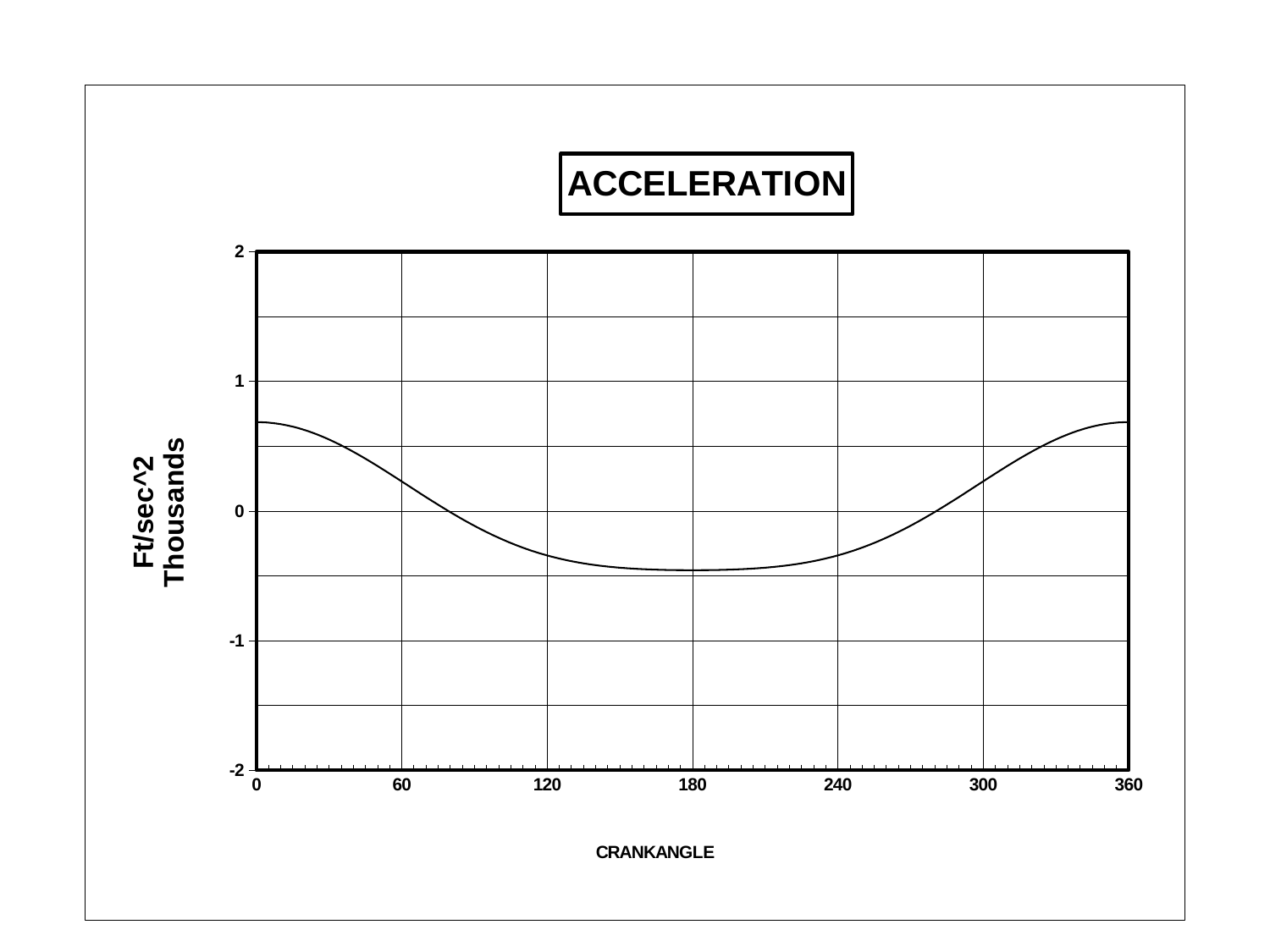
Is the acceleration value at a crank angle of 180 greater or less than -1? greater What is the title of the chart? ACCELERATION What is the label of the x axis? CRANKANGLE What kind of chart is shown on the slide? line chart Which is larger, the acceleration at a crank angle of 0 or at a crank angle of 180? 0 Is the acceleration value at a crank angle of 0 greater or less than 0? greater Is the acceleration value at a crank angle of 180 greater or less than 0? less At which labelled crank angle does the acceleration curve reach its lowest value? 180 Does the acceleration rise or fall as the crank angle goes from 0 to 180? fall